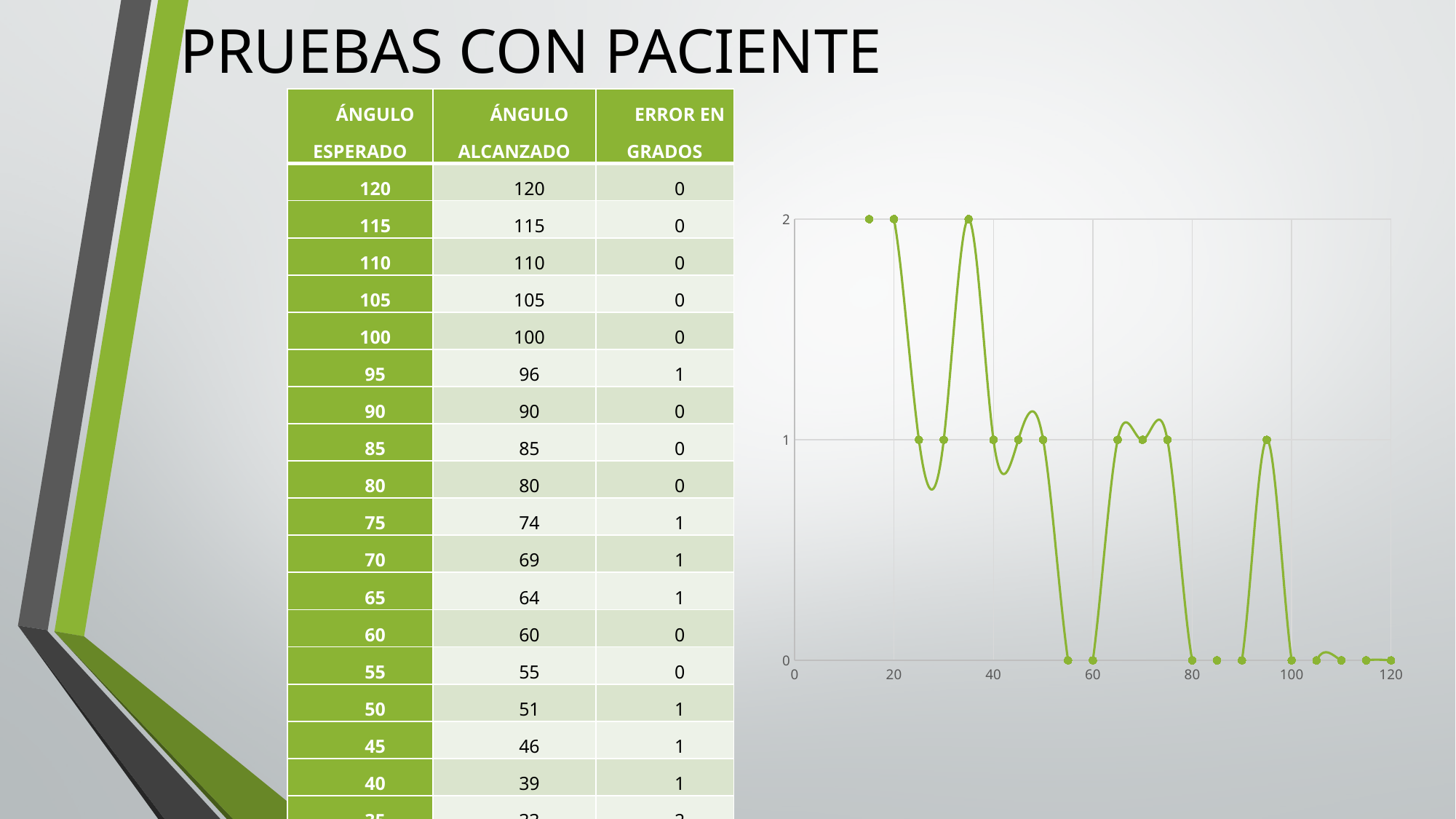
Is the plotted value at x = 35 greater or less than 1? greater What is the difference between the plotted values at x = 35 and x = 40? 1 What type of chart is shown on the right of the slide? scatter chart with smooth lines Do the plotted values generally rise or fall as x increases along the chart? fall What is the plotted value at x = 20 on the chart? 2 What is the maximum value shown on the x axis of the chart? 120 Which has the larger plotted value on the chart, x = 20 or x = 100? x = 20 What is the plotted value at x = 60 on the chart? 0 What is the highest value reached by any point on the chart? 2 What is the lowest value reached by any point on the chart? 0 What is the plotted value at x = 35 on the chart? 2 What is the plotted value at x = 95 on the chart? 1